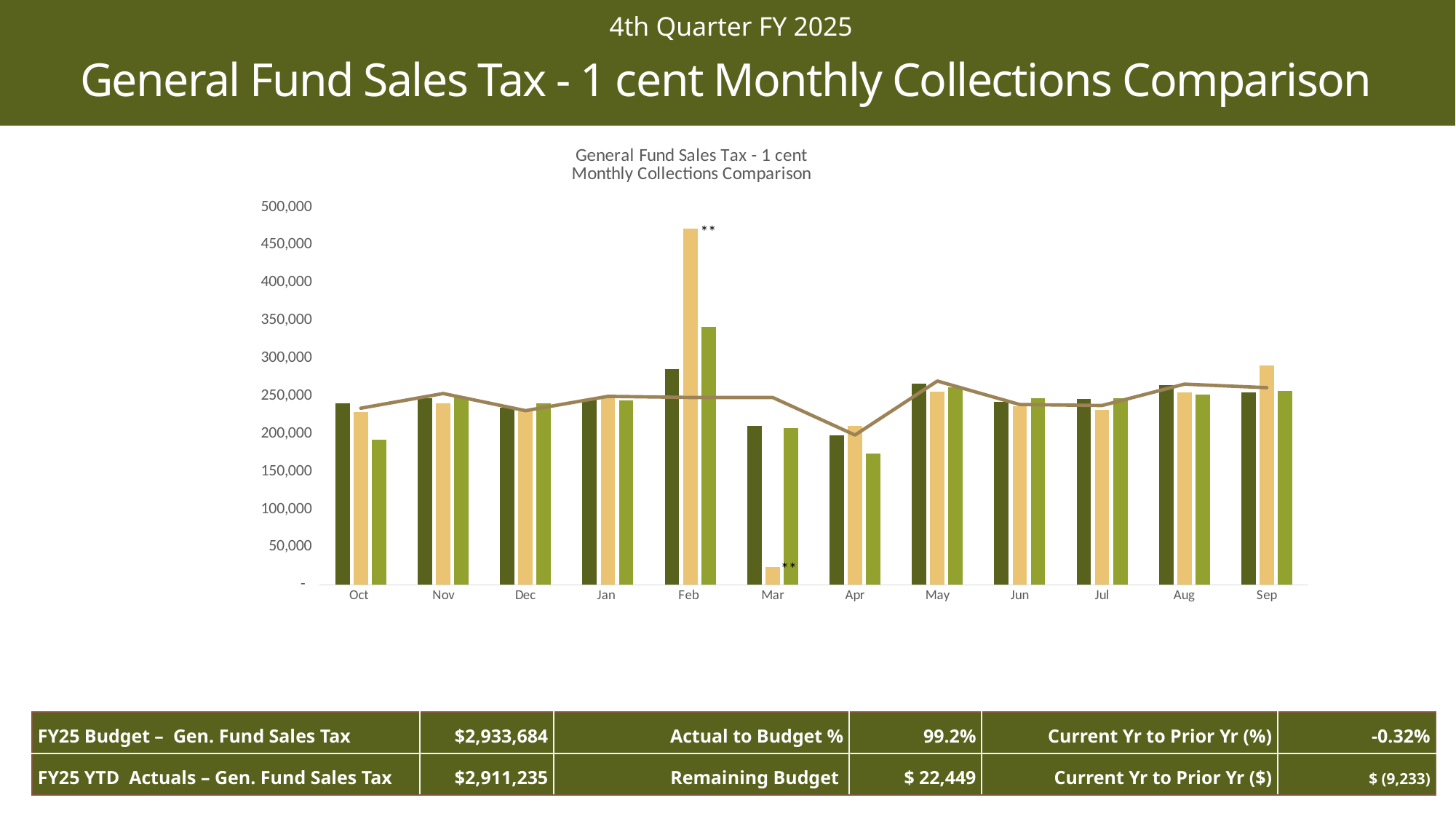
In Feb, which is larger: the tan bar or the light green bar? the tan bar In which month does the tallest bar in the chart appear? Feb How many bars are plotted for each month in the chart? 3 In which month does the shortest bar in the chart appear? Mar How many months are shown along the x axis of the chart? 12 In Oct, which is larger: the dark green bar or the light green bar? the dark green bar Is the value of the light green bar for Feb greater or less than 300,000? greater Is the value of the tan bar for Feb greater or less than 400,000? greater Is the value of the light green bar for Apr greater or less than 200,000? less What kind of chart is shown on the slide? combination bar and line chart What is the title of the chart? General Fund Sales Tax - 1 cent Monthly Collections Comparison